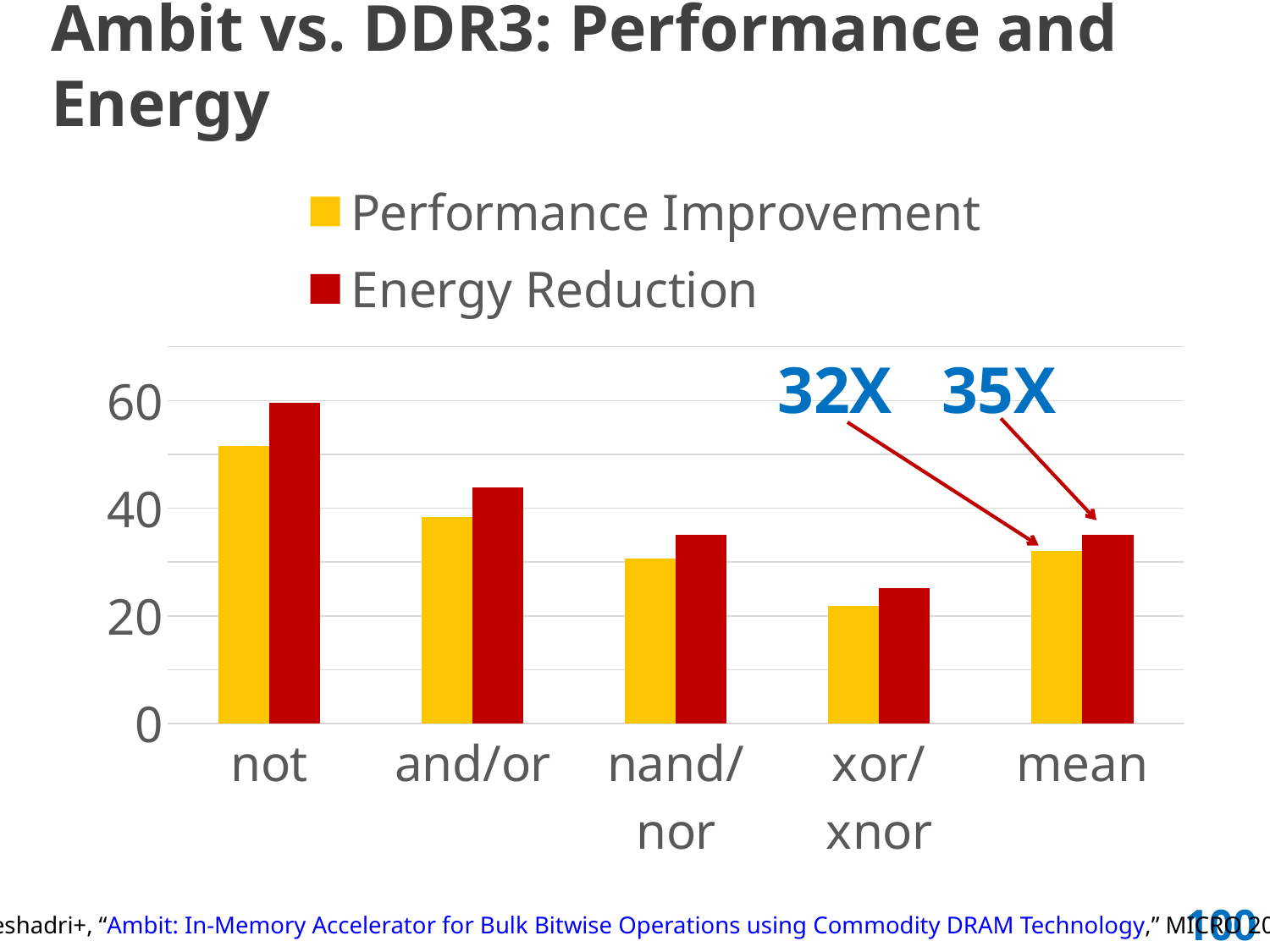
What is the Energy Reduction value for the mean category? 35X Which category has the lowest Energy Reduction? xor/xnor What kind of chart is shown on the slide? bar chart Which category has the highest Performance Improvement? not Is the Energy Reduction value for xor/xnor greater or less than 40? less Is the Performance Improvement value for not greater or less than 40? greater For the not category, which is larger: Performance Improvement or Energy Reduction? Energy Reduction What is the difference between the Energy Reduction and Performance Improvement values for the mean category? 3X Do the Performance Improvement values rise or fall from not to xor/xnor? fall What is the Performance Improvement value for the mean category? 32X How many categories are shown on the x axis? 5 How many series does the legend list? 2